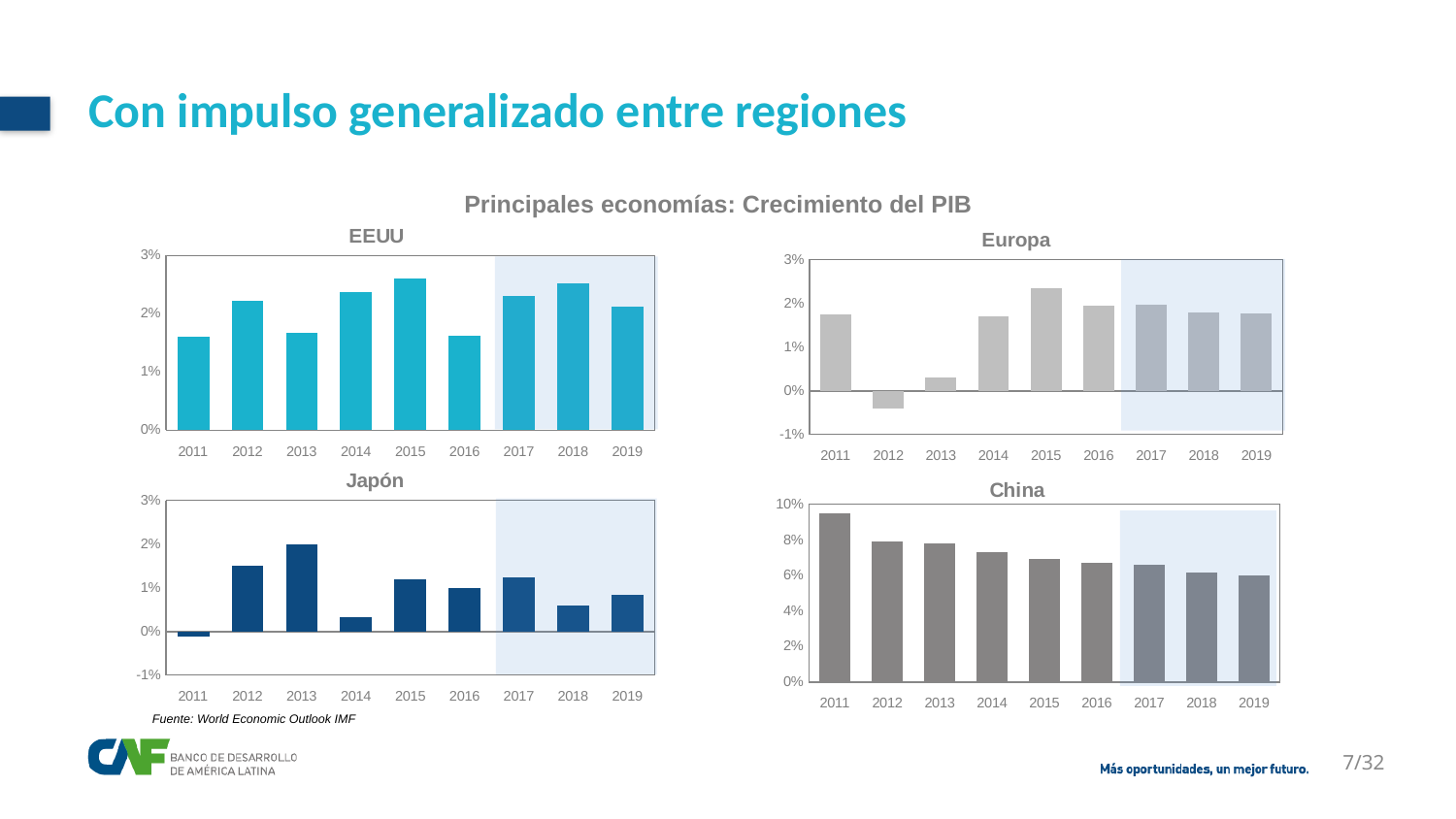
What kind of chart is the Japón chart? bar chart In the China chart, is the value for 2011 greater or less than 8%? greater In the Europa chart, which year has the highest value? 2015 In the Europa chart, which year has the lowest value? 2012 In the China chart, do the values rise or fall from 2011 to 2019? fall In the China chart, which year has the highest GDP growth? 2011 In the Europa chart, is the value for 2012 greater or less than 0%? less In the Japón chart, which year has the lowest value? 2011 How many years are shown on the x axis of the EEUU chart? 9 In the EEUU chart, is the value for 2015 greater or less than 2%? greater In the Japón chart, which year has the larger value, 2012 or 2014? 2012 In the Japón chart, which year has the highest value? 2013